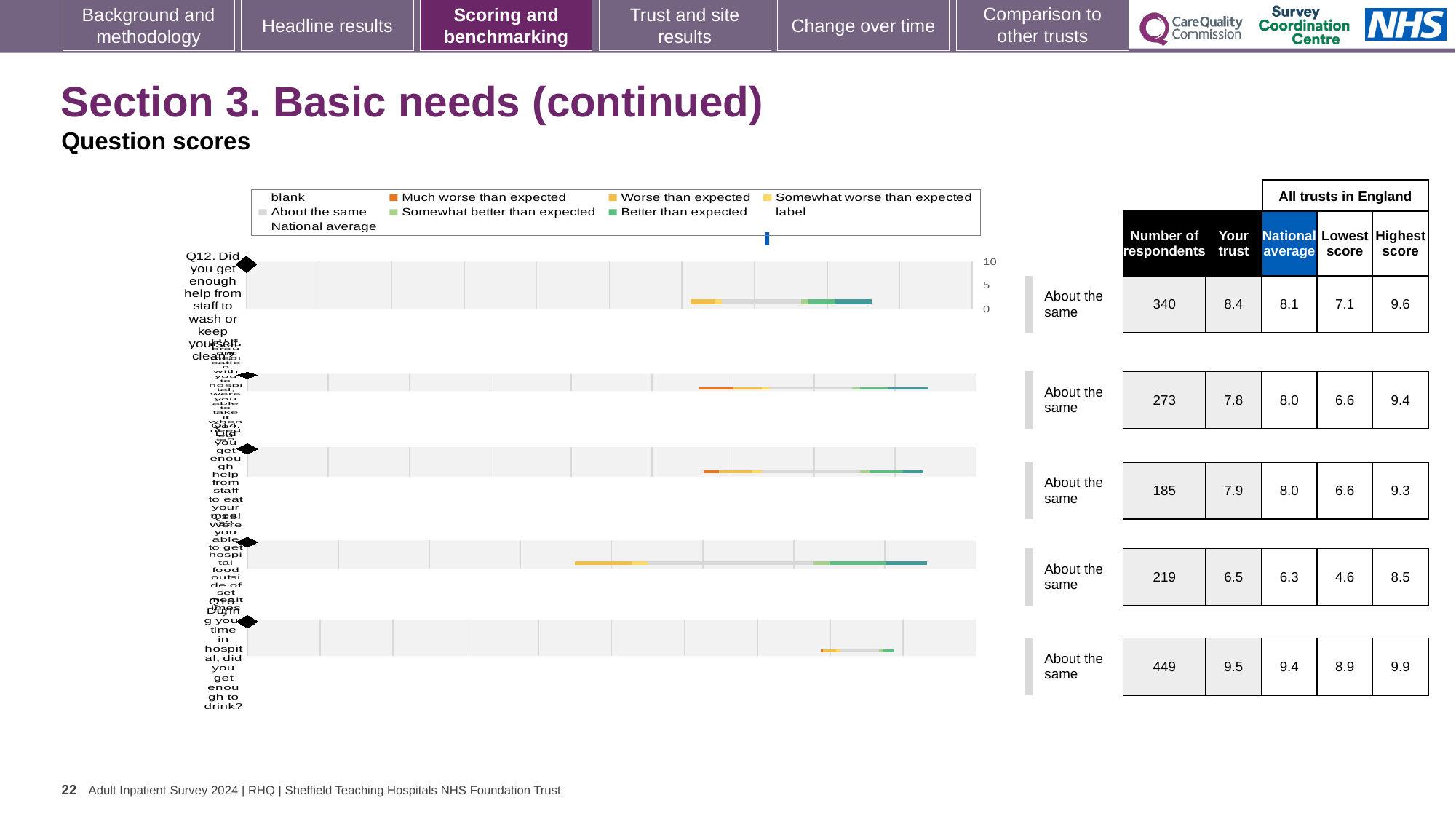
What kind of chart is used to show the question scores on this slide? bar chart In the table next to the chart, what is the 'Your trust' score for Q12 (help from staff to wash or keep yourself clean)? 8.4 In the table, what is the highest score across all trusts in England for the last row (Q16, did you get enough to drink)? 9.9 In the table, what is the national average for Q12 (help from staff to wash or keep yourself clean)? 8.1 Which row has the lowest 'Your trust' score in the table? the fourth row (hospital food outside of set meal times), 6.5 In the table, how many respondents are listed for the last row (Q16, did you get enough to drink)? 449 What benchmark category is shown beside every row of the chart? About the same Which row has the highest 'Your trust' score in the table? Q16 (did you get enough to drink), 9.5 What is the difference between the 'Your trust' score and the national average for Q12? 0.3 How many questions (rows) are plotted in the chart? 5 For Q12, which is larger: the 'Your trust' score or the national average? Your trust